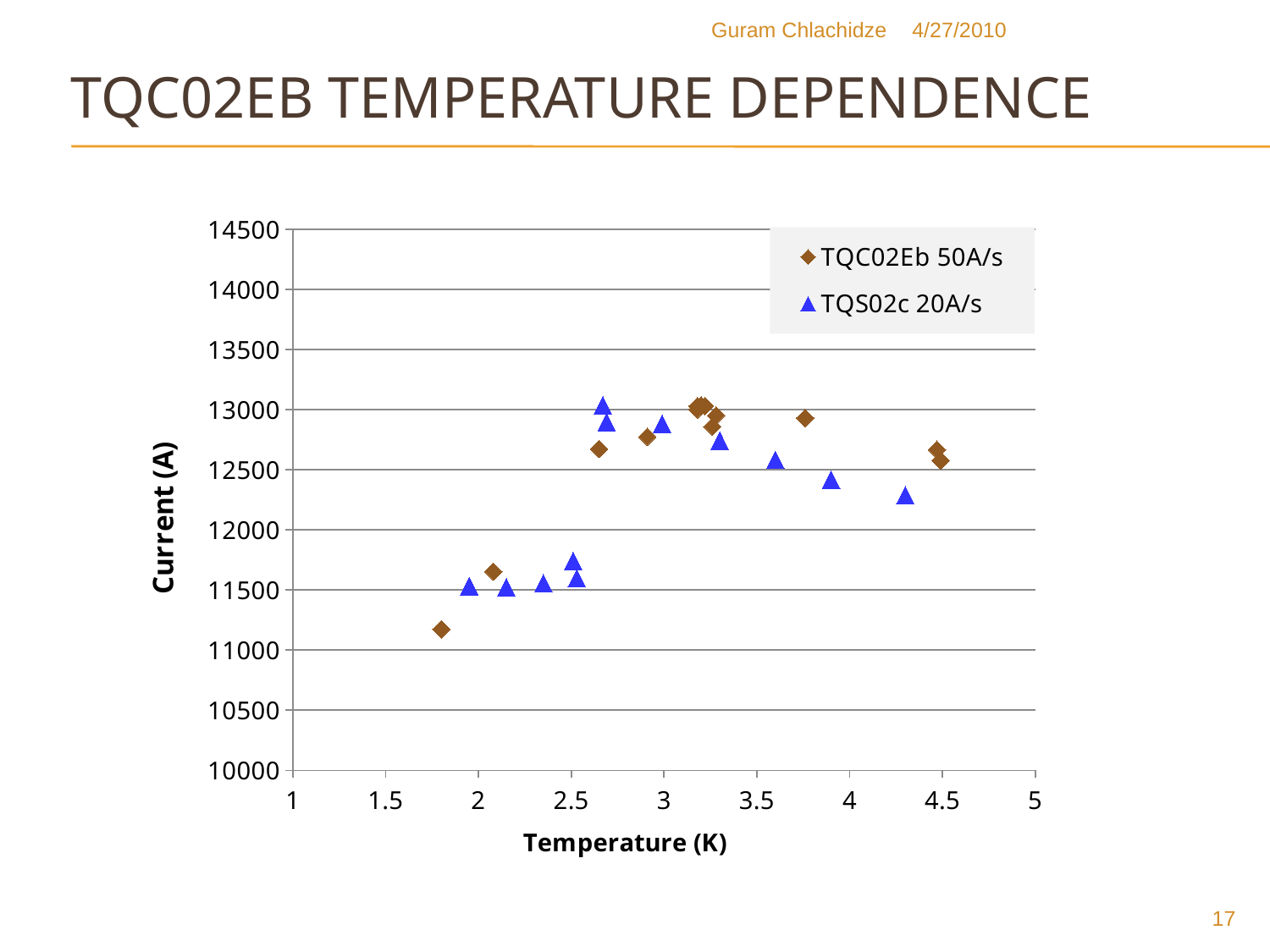
Which series contains the lowest plotted current value on the chart? TQC02Eb 50A/s Is the current for the TQC02Eb 50A/s point near 3.75 K greater or less than 12500? greater What is the title of the vertical axis? Current (A) Is the current for the TQC02Eb 50A/s point near 1.8 K greater or less than 11500? less Do the TQC02Eb 50A/s values rise or fall as temperature increases from 1.8 K to 3.2 K? rise Is the current for the TQC02Eb 50A/s point near 2.65 K greater or less than 12500? greater What kind of chart is shown on the slide? scatter chart Do the TQS02c 20A/s values rise or fall as temperature increases from 3 K to 4.5 K? fall What are the two series named in the legend? TQC02Eb 50A/s and TQS02c 20A/s How many series does the legend list? 2